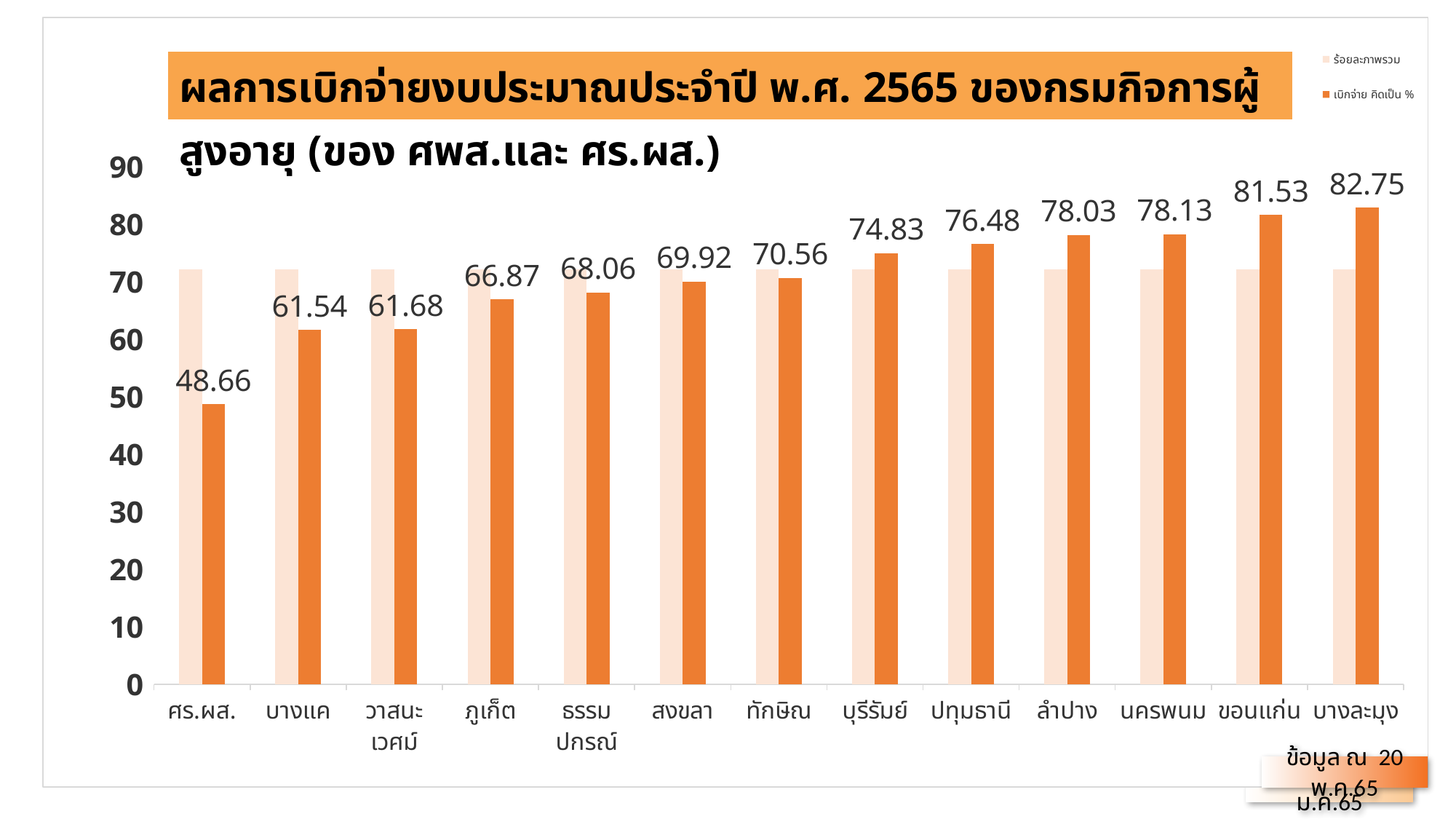
What is the difference between the เบิกจ่าย คิดเป็น % values for บางละมุง and ศร.ผส.? 34.09 What kind of chart is shown on the slide? bar chart How many categories are shown on the x axis? 13 Which has a larger เบิกจ่าย คิดเป็น % value, สงขลา or ทักษิณ? ทักษิณ What is the เบิกจ่าย คิดเป็น % value for ภูเก็ต? 66.87 Do the เบิกจ่าย คิดเป็น % values rise or fall from left to right along the x axis? rise Which category has the lowest เบิกจ่าย คิดเป็น % value? ศร.ผส. What is the เบิกจ่าย คิดเป็น % value for ศร.ผส.? 48.66 Is the ร้อยละภาพรวม value for บางแค greater or less than 60? greater What is the เบิกจ่าย คิดเป็น % value for ลำปาง? 78.03 How many series does the legend list? 2 Which category has the highest เบิกจ่าย คิดเป็น % value? บางละมุง